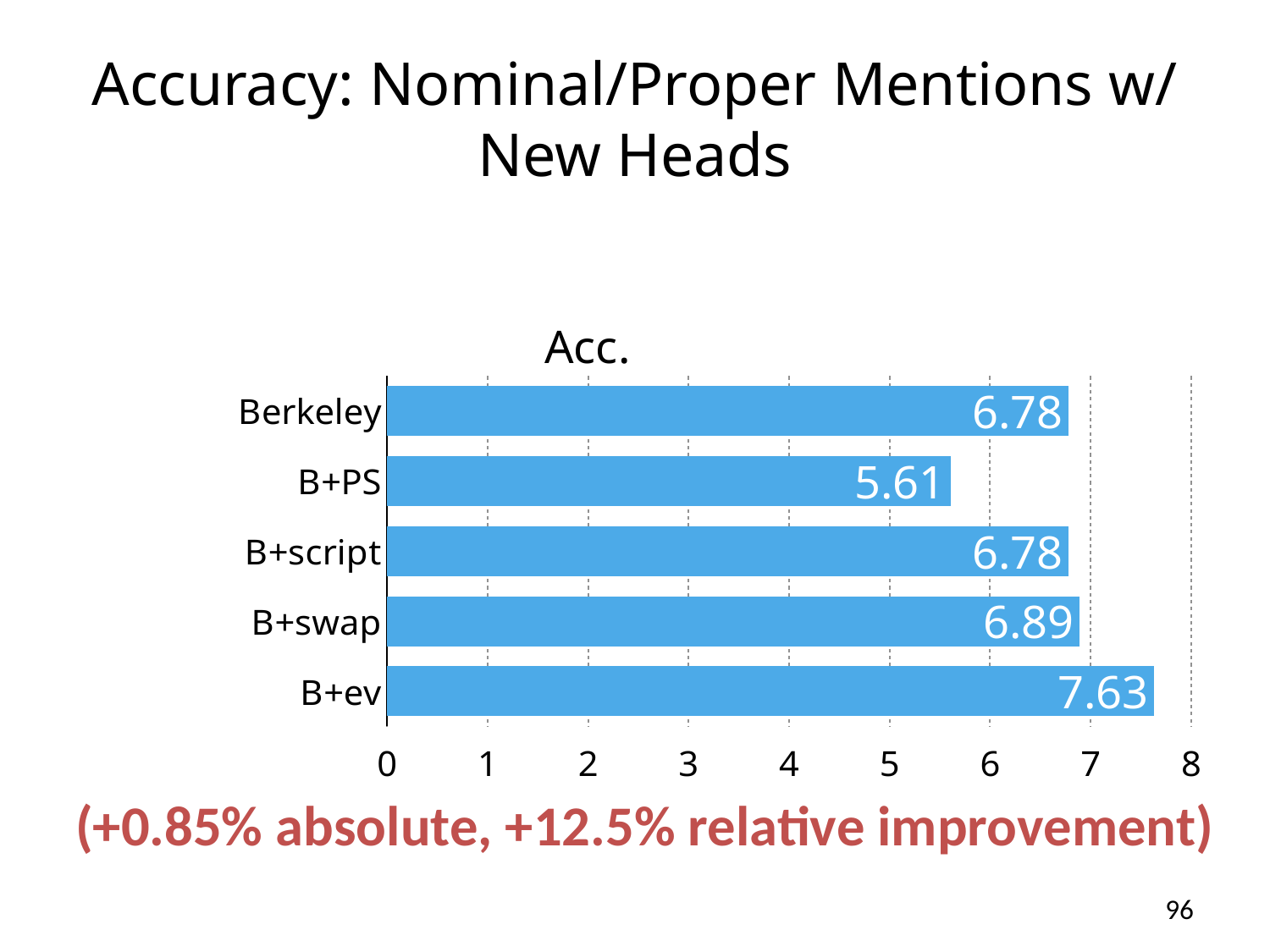
What kind of chart is shown on the slide? bar chart Which has a larger Acc. value, B+swap or B+script? B+swap Which category has the highest Acc. value? B+ev What is the title of the chart? Acc. What is the Acc. value for B+swap? 6.89 How many categories are shown in the chart? 5 Which category has the lowest Acc. value? B+PS What is the Acc. value for B+ev? 7.63 What is the difference between the Acc. values for B+ev and Berkeley? 0.85 What is the difference between the Acc. values for Berkeley and B+PS? 1.17 Is the value for B+PS greater or less than 6? less What is the Acc. value for B+PS? 5.61